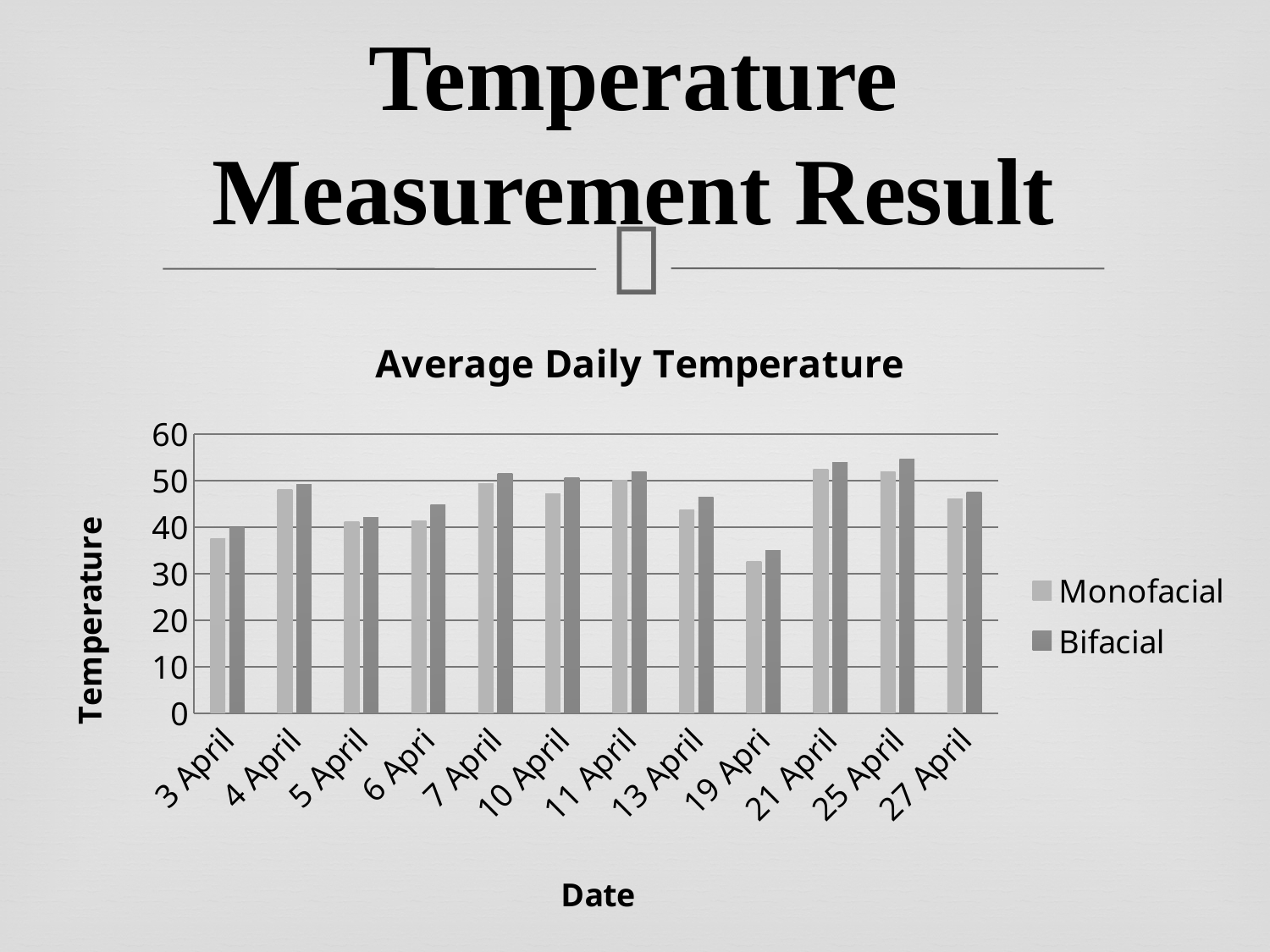
Is the Bifacial value for 19 Apri greater or less than 40? less What is the title of the chart? Average Daily Temperature Is the Monofacial value for 21 April greater or less than 50? greater On 6 Apri, which series has the larger value, Monofacial or Bifacial? Bifacial What is the label of the vertical axis? Temperature How many series does the legend list? 2 Which date has the lowest Bifacial temperature? 19 Apri What kind of chart is shown on the slide? bar chart How many dates are shown on the x axis? 12 Is the Monofacial value for 3 April greater or less than 40? less Which date has the lowest Monofacial temperature? 19 Apri